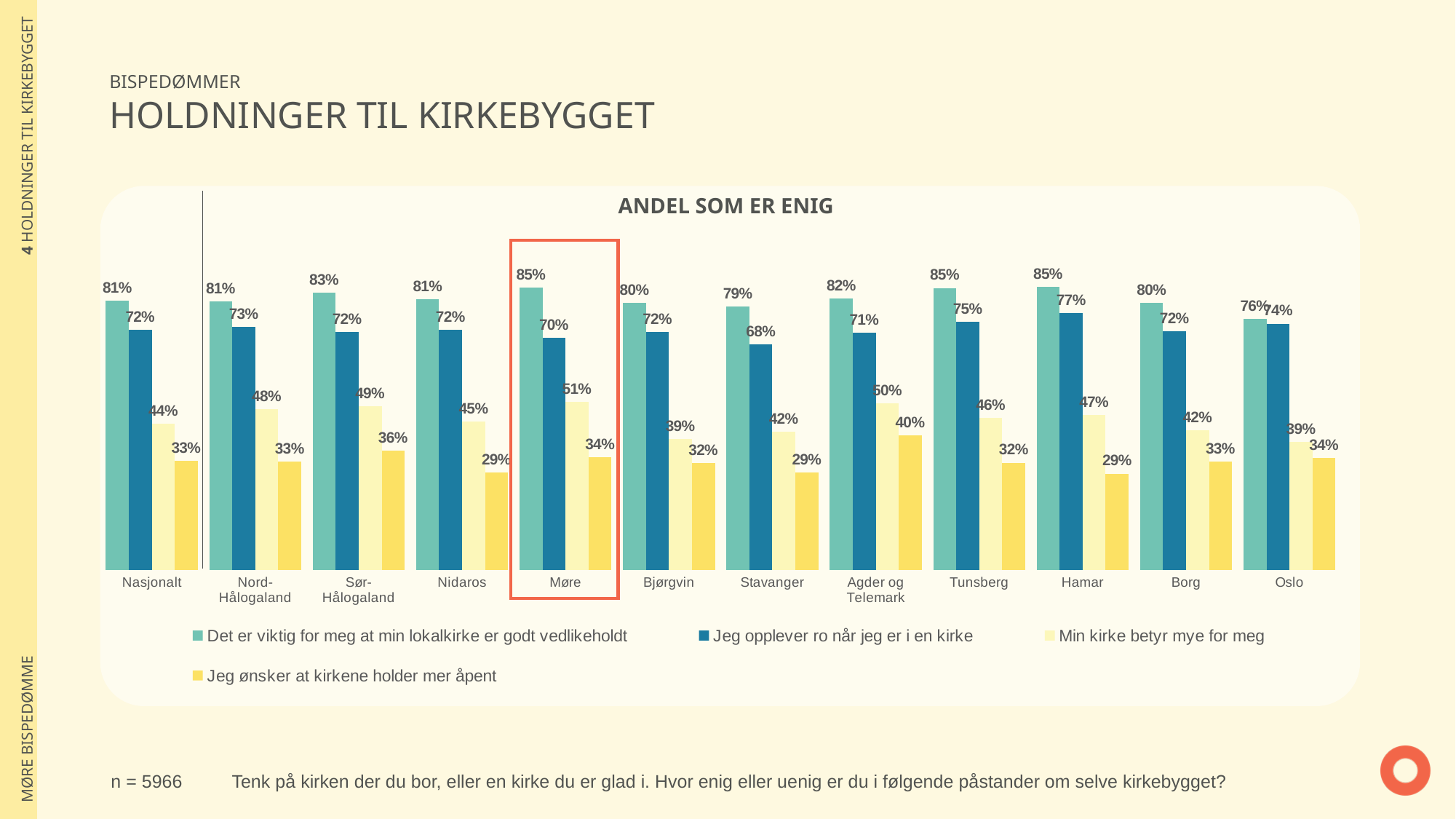
What is the value for Agder og Telemark in the series "Jeg ønsker at kirkene holder mer åpent"? 40% What is the difference between the "Det er viktig for meg at min lokalkirke er godt vedlikeholdt" value and the "Jeg opplever ro når jeg er i en kirke" value for Møre? 15 percentage points Which category has the highest value in the series "Jeg opplever ro når jeg er i en kirke"? Hamar What is the title of the chart? ANDEL SOM ER ENIG Which category has the highest value in the series "Min kirke betyr mye for meg"? Møre What kind of chart is shown on the slide? Bar chart Which category has the lowest value in the series "Det er viktig for meg at min lokalkirke er godt vedlikeholdt"? Oslo How many series does the legend list? 4 How many categories are shown on the x axis? 12 What is the value for Møre in the series "Det er viktig for meg at min lokalkirke er godt vedlikeholdt"? 85% What is the value for Stavanger in the series "Jeg opplever ro når jeg er i en kirke"? 68% Which is larger: the "Jeg opplever ro når jeg er i en kirke" value for Oslo or for Stavanger? Oslo